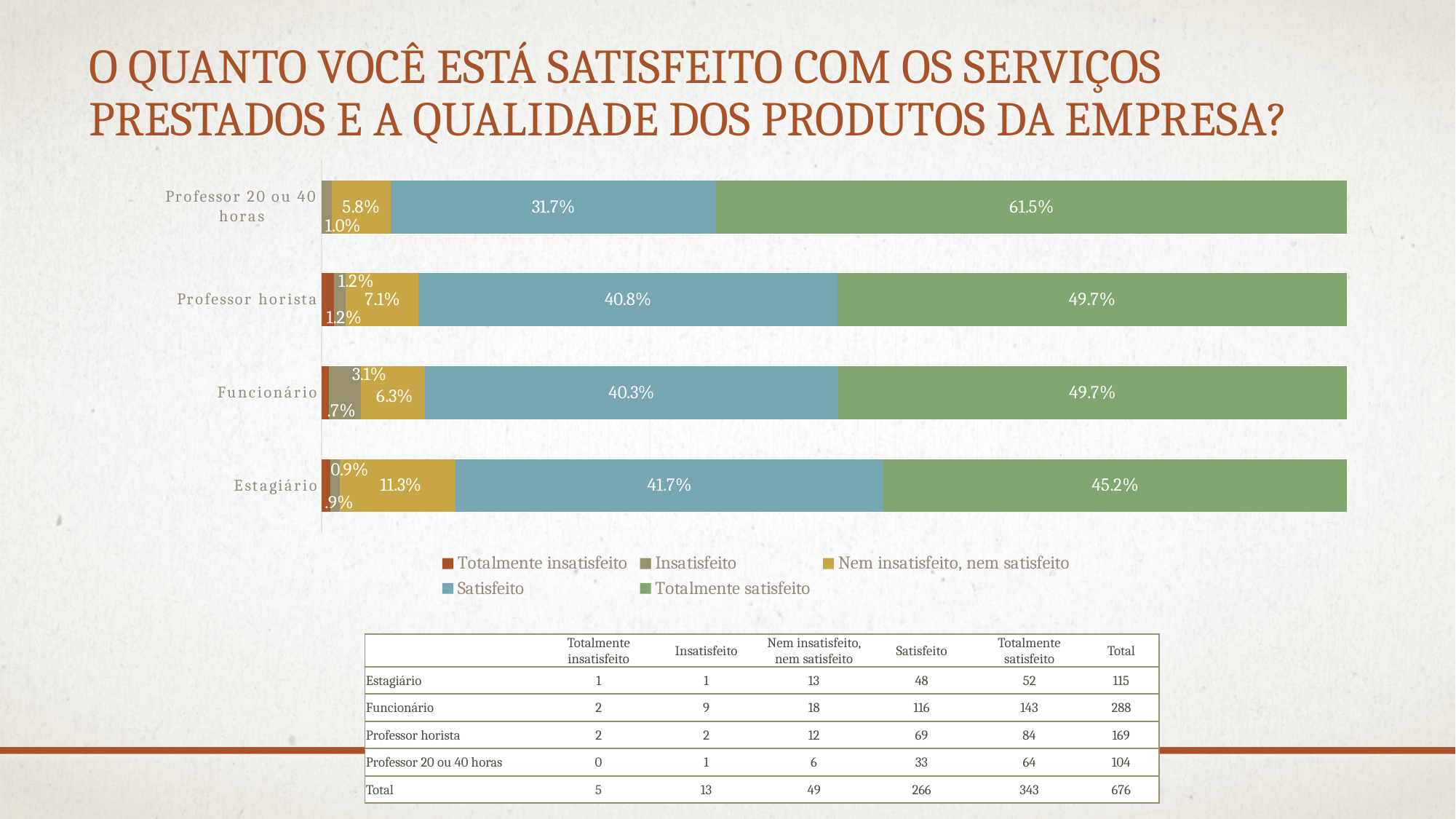
What is the 'Nem insatisfeito, nem satisfeito' value for 'Professor horista'? 7.1% What is the 'Totalmente satisfeito' value for 'Professor 20 ou 40 horas'? 61.5% Which category has the highest 'Totalmente satisfeito' value? Professor 20 ou 40 horas What type of chart is shown on the slide? Stacked bar chart How many categories are plotted on the chart? 4 What is the 'Satisfeito' value for 'Estagiário'? 41.7% Which is larger: the 'Nem insatisfeito, nem satisfeito' value for 'Estagiário' or for 'Funcionário'? Estagiário Which legend entry is shown in green? Totalmente satisfeito How many series does the legend list? 5 What is the difference between the 'Totalmente satisfeito' values for 'Professor 20 ou 40 horas' and 'Estagiário'? 16.3% Which category has the lowest 'Satisfeito' value? Professor 20 ou 40 horas What is the 'Insatisfeito' value for 'Funcionário'? 3.1%